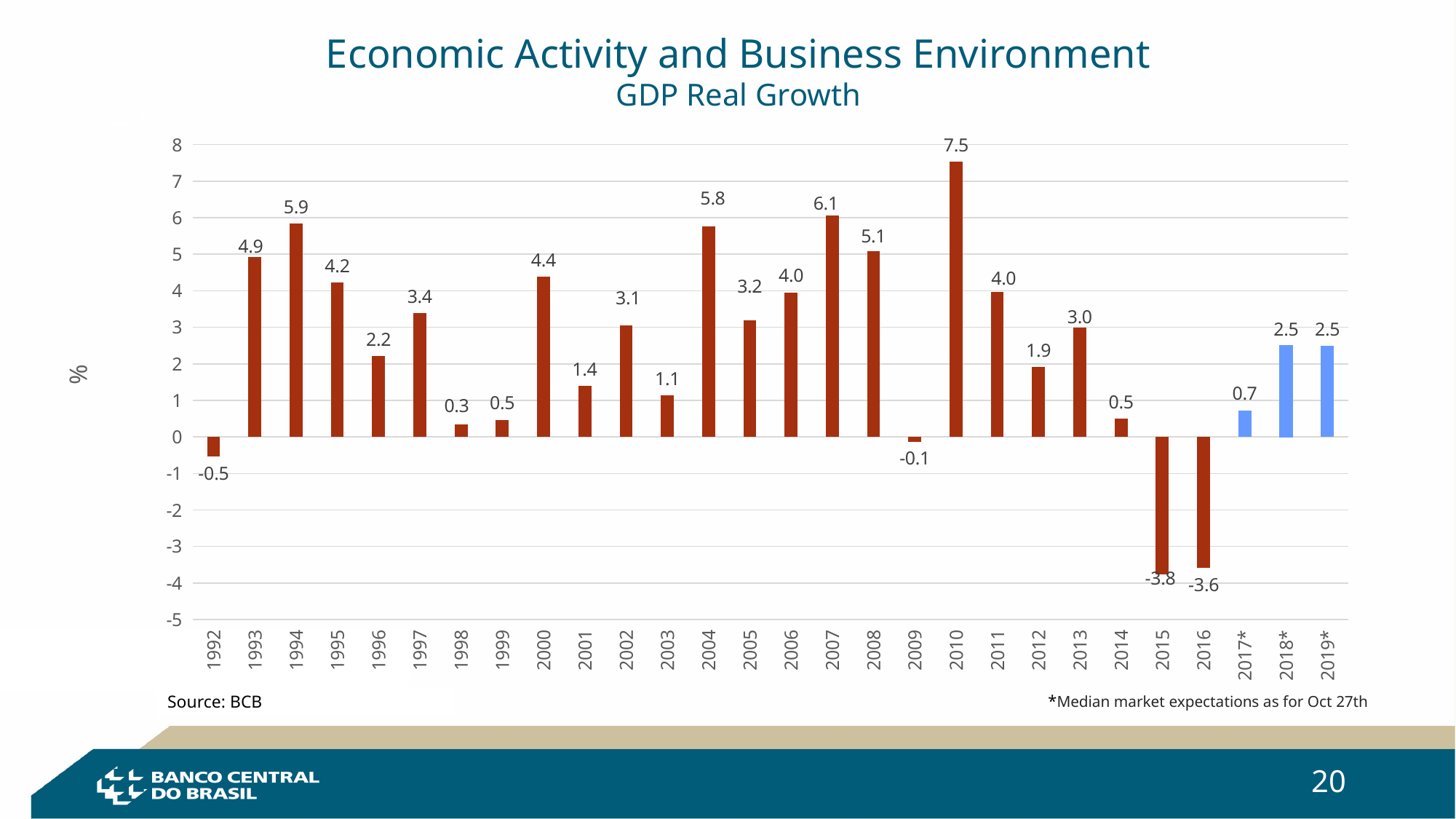
What is the GDP real growth value for 2017*? 0.7 Which year has the lowest GDP real growth? 2015 What is the difference between the GDP real growth values for 2007 and 2008? 1.0 What kind of chart is shown on the slide? bar chart How many years are shown on the x axis of the chart? 28 What is the GDP real growth value for 2015? -3.8 What is the GDP real growth value for 2010? 7.5 Which year has a larger GDP real growth value, 1994 or 2004? 1994 Do the GDP real growth values rise or fall from 2013 to 2015? fall Is the value for 2000 greater or less than 4? greater Which year has the highest GDP real growth? 2010 What is the source cited below the chart? BCB